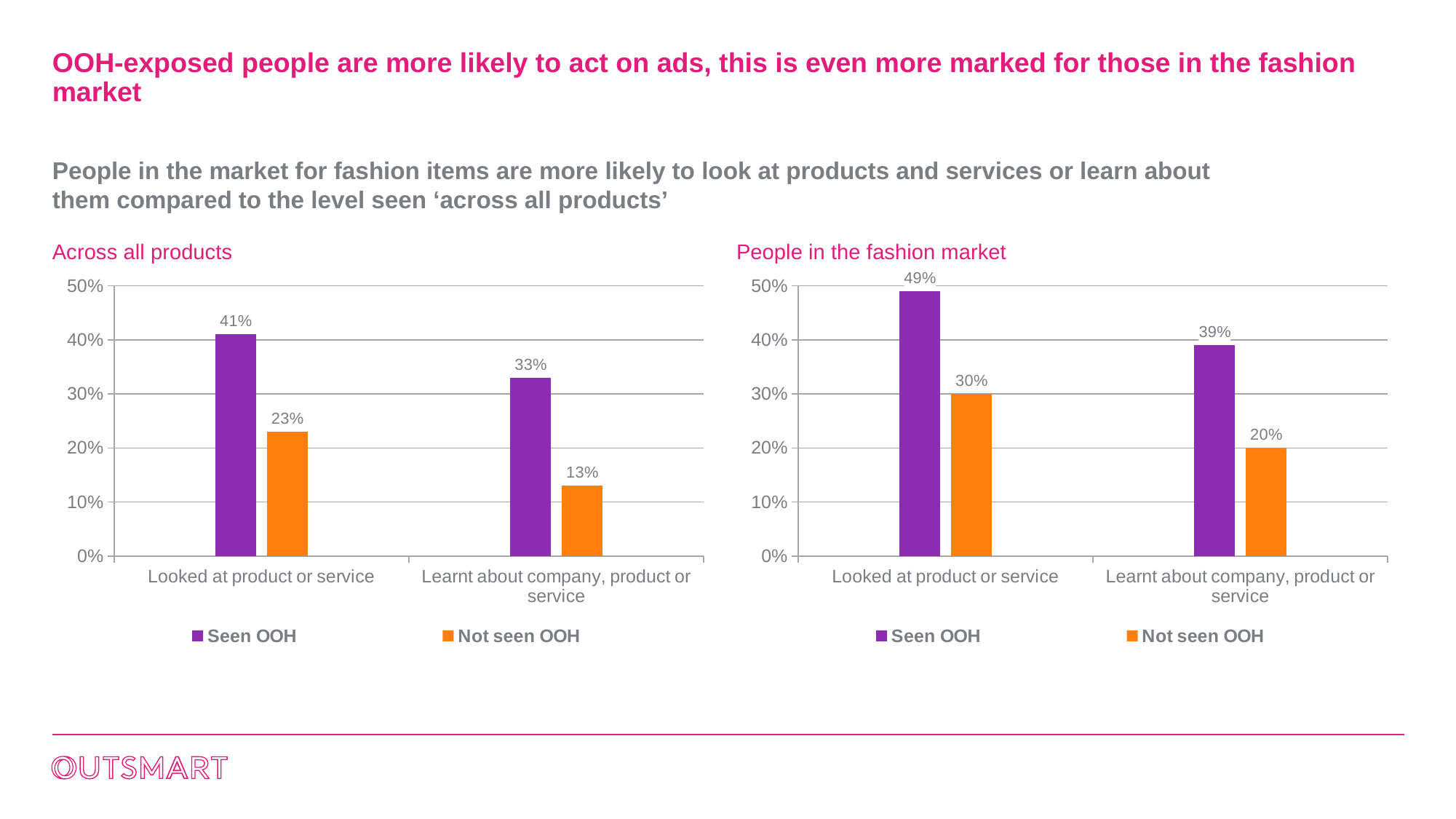
In the 'People in the fashion market' chart, what is the value for Not seen OOH for 'Learnt about company, product or service'? 20% In the 'Across all products' chart, what is the value for Not seen OOH for 'Learnt about company, product or service'? 13% How many series does the legend of the 'Across all products' chart list? 2 In the 'People in the fashion market' chart, which bar is the highest? Seen OOH, Looked at product or service What kind of chart is the 'Across all products' chart? Bar chart In the 'Across all products' chart, which bar is the lowest? Not seen OOH, Learnt about company, product or service In the 'Across all products' chart, what is the difference between Seen OOH and Not seen OOH for 'Looked at product or service'? 18% In the 'People in the fashion market' chart, which is larger for 'Looked at product or service': Seen OOH or Not seen OOH? Seen OOH In the 'Across all products' chart, what is the value for Seen OOH for 'Looked at product or service'? 41% In the 'People in the fashion market' chart, what is the value for Seen OOH for 'Looked at product or service'? 49% In the 'People in the fashion market' chart, what is the difference between Seen OOH and Not seen OOH for 'Learnt about company, product or service'? 19% How many categories are shown on the x axis of the 'People in the fashion market' chart? 2